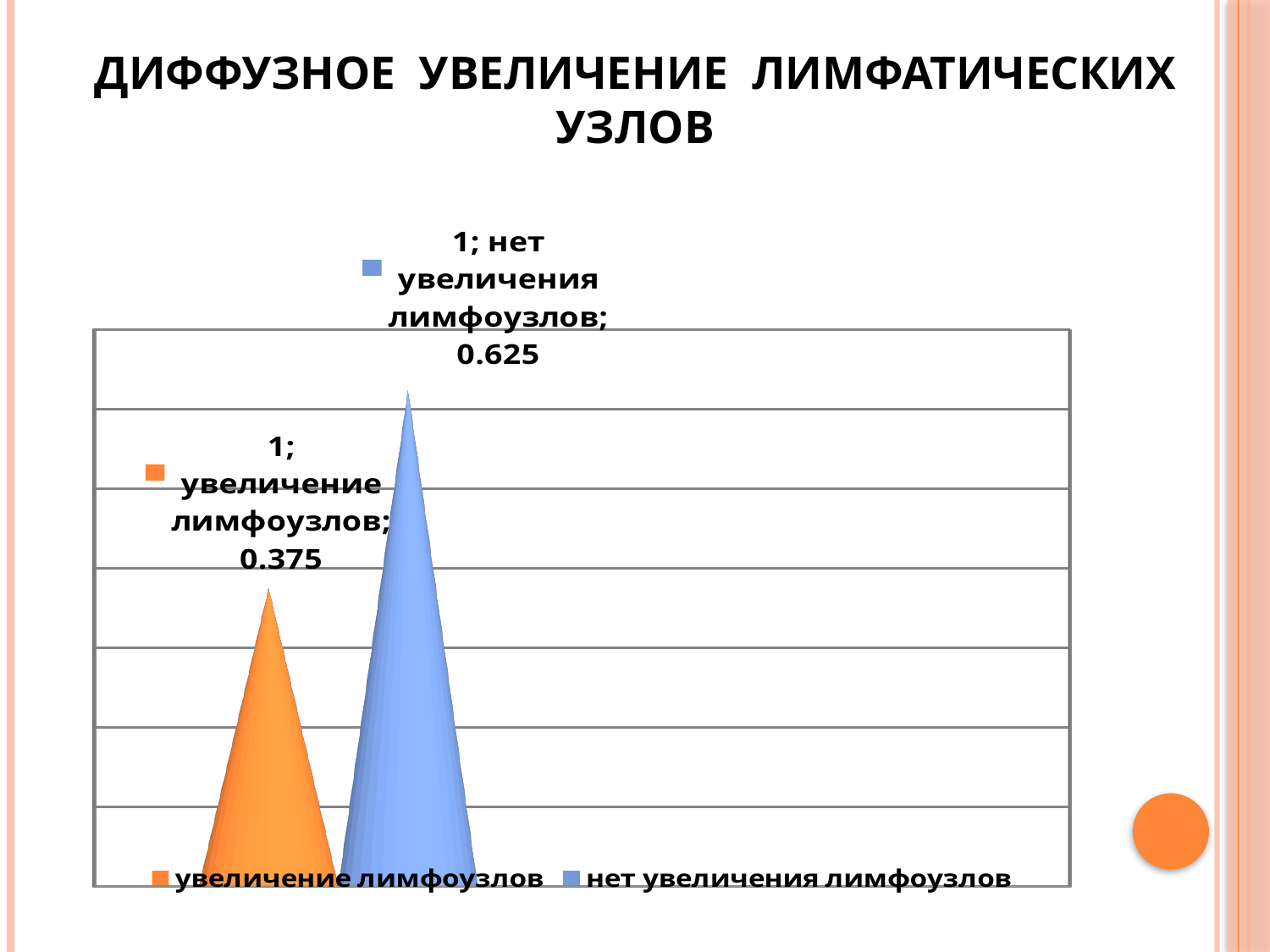
What kind of chart is shown on the slide? bar chart Which is larger: the value for "увеличение лимфоузлов" or for "нет увеличения лимфоузлов"? нет увеличения лимфоузлов What is the title of the slide? ДИФФУЗНОЕ УВЕЛИЧЕНИЕ ЛИМФАТИЧЕСКИХ УЗЛОВ What is the value for "увеличение лимфоузлов"? 0.375 How many bars are plotted on the chart? 2 Which series has the highest value? нет увеличения лимфоузлов Which series has the lowest value? увеличение лимфоузлов What is the value for "нет увеличения лимфоузлов"? 0.625 What colour is the bar for "нет увеличения лимфоузлов"? blue What is the difference between the values for "нет увеличения лимфоузлов" and "увеличение лимфоузлов"? 0.25 How many series does the legend list? 2